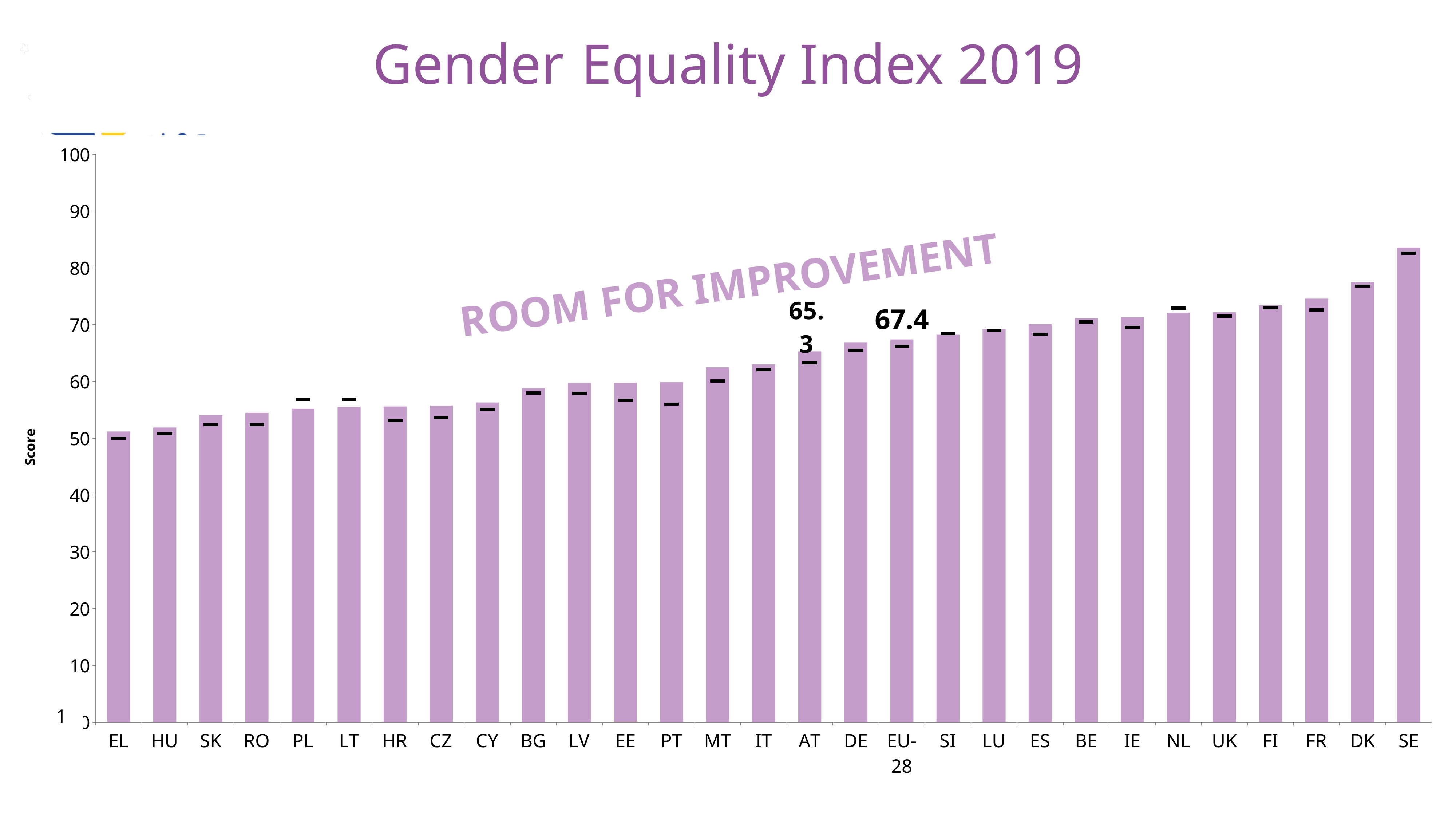
Is the value for DK greater or less than 80? less Which category has the lowest bar? EL Do the bar values rise or fall from left to right along the x axis? rise Is the value for SE greater or less than 80? greater How many categories are shown on the x axis? 29 What is the value shown for AT? 65.3 What is the difference between the EU-28 value and the AT value? 2.1 What is the value shown for EU-28? 67.4 Which category has the highest bar? SE Which has the larger value, SE or DK? SE Is the value for SK greater or less than 60? less What kind of chart is shown on the slide? bar chart